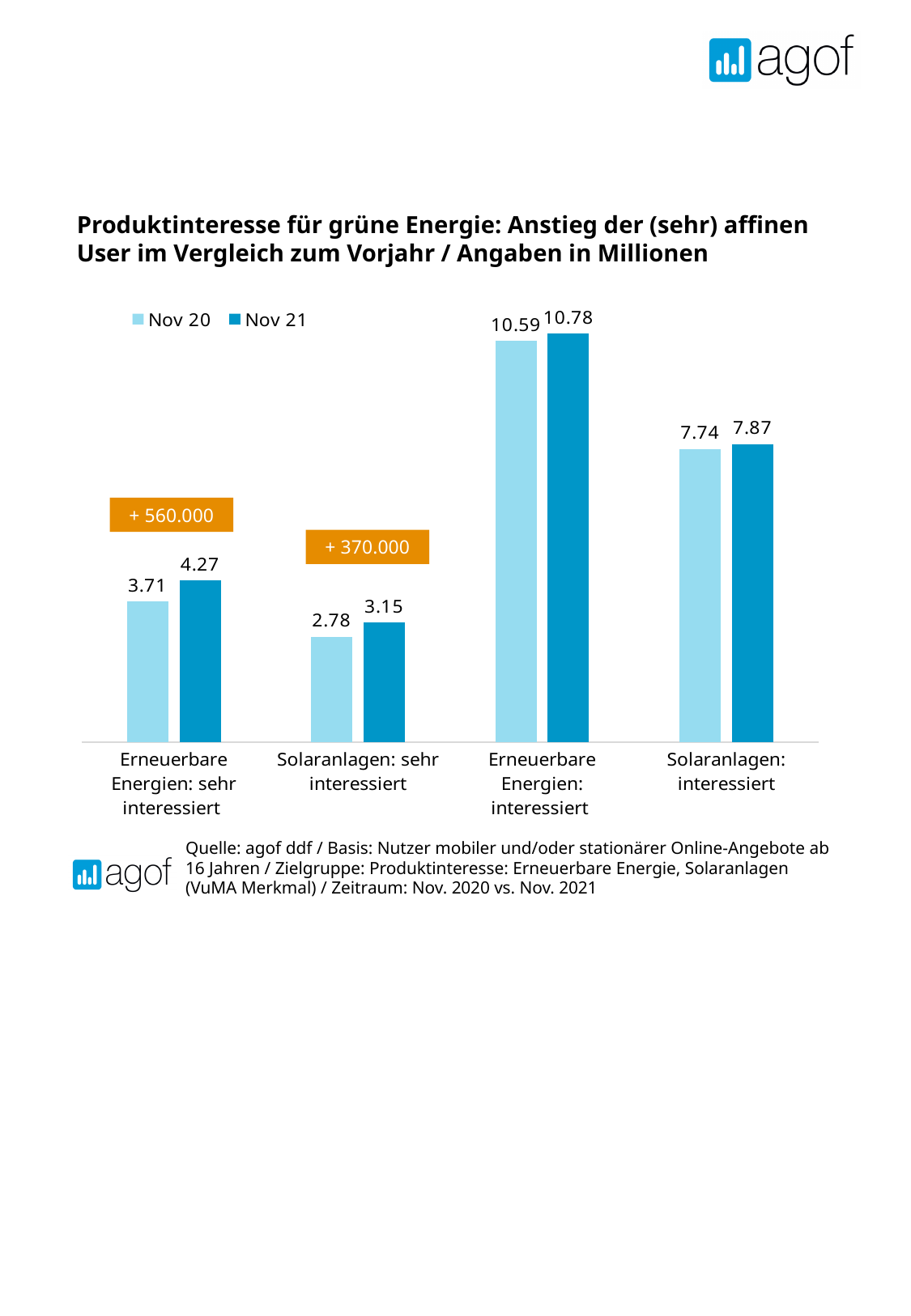
What is the Nov 21 value for "Erneuerbare Energien: interessiert"? 10.78 What is the Nov 20 value for "Solaranlagen: interessiert"? 7.74 Which category has the highest Nov 21 value? Erneuerbare Energien: interessiert What increase is shown in the orange label above "Solaranlagen: sehr interessiert"? + 370.000 How many series does the legend list? 2 Which category has the lowest Nov 20 value? Solaranlagen: sehr interessiert What is the Nov 21 value for "Solaranlagen: sehr interessiert"? 3.15 What is the difference between the Nov 21 and Nov 20 values for "Erneuerbare Energien: sehr interessiert"? 0.56 How many categories are shown on the x axis? 4 What is the Nov 20 value for "Erneuerbare Energien: sehr interessiert"? 3.71 What kind of chart is shown on the slide? Bar chart Which is larger: the Nov 21 value for "Solaranlagen: interessiert" or the Nov 21 value for "Erneuerbare Energien: sehr interessiert"? Solaranlagen: interessiert